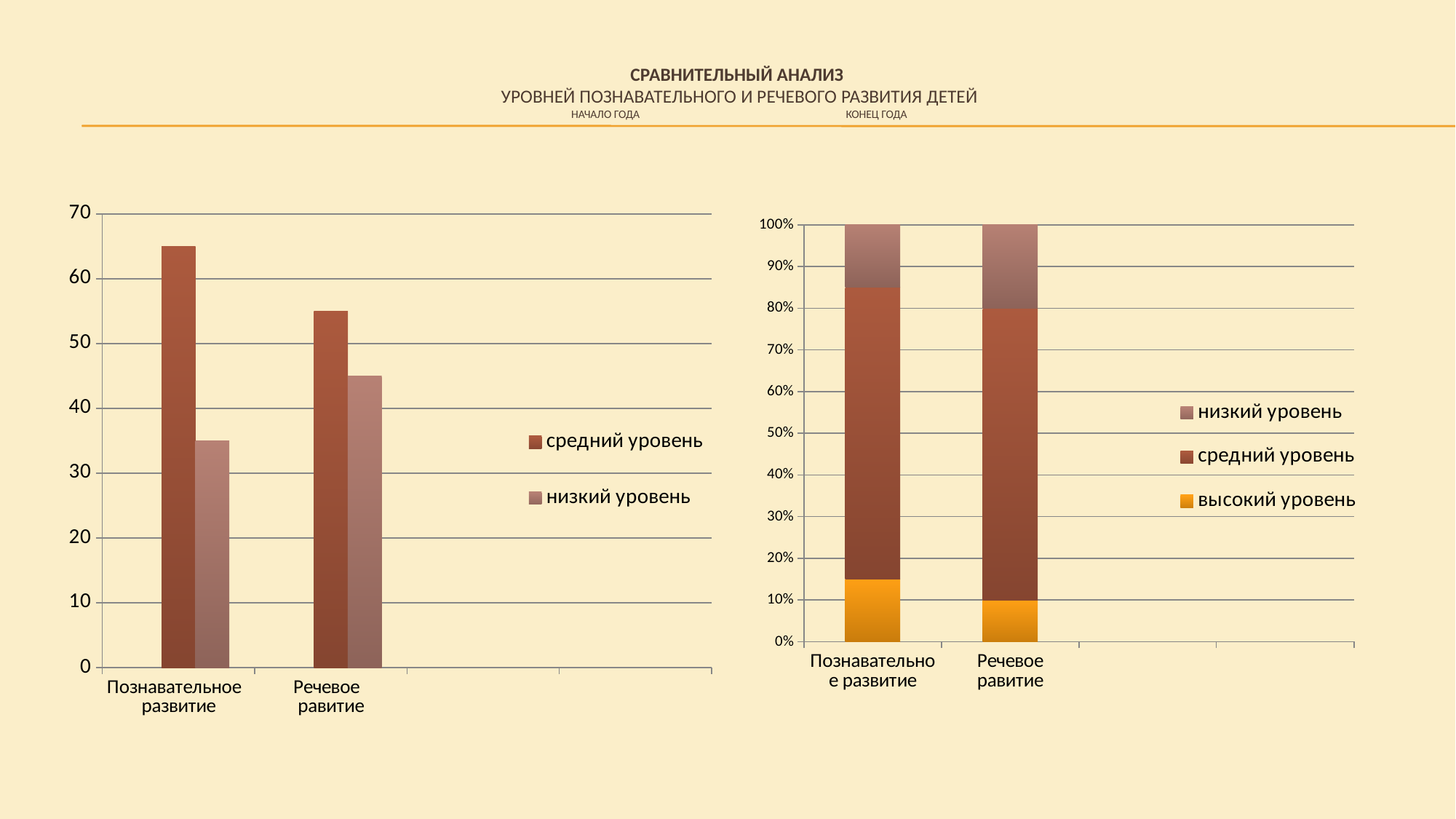
In the left chart (НАЧАЛО ГОДА), which category has the higher value for низкий уровень? Речевое равитие In the left chart (НАЧАЛО ГОДА), is the value of низкий уровень for Познавательное развитие greater or less than 40? less How many series does the legend of the right chart (КОНЕЦ ГОДА) list? 3 How many series does the legend of the left chart (НАЧАЛО ГОДА) list? 2 In the right chart (КОНЕЦ ГОДА), which category has the larger share of низкий уровень? Речевое равитие How many categories are shown on the x axis of the left chart (НАЧАЛО ГОДА)? 2 In the right chart (КОНЕЦ ГОДА), what is the share of высокий уровень for Речевое равитие? 10% In the right chart (КОНЕЦ ГОДА), is the share of высокий уровень for Познавательное развитие greater or less than 10%? greater In the left chart (НАЧАЛО ГОДА), is the value of средний уровень for Познавательное развитие greater or less than 60? greater In the left chart (НАЧАЛО ГОДА), which category has the higher value for средний уровень? Познавательное развитие What kind of chart is the left chart (НАЧАЛО ГОДА)? bar chart In the right chart (КОНЕЦ ГОДА), which series is shown in orange? высокий уровень